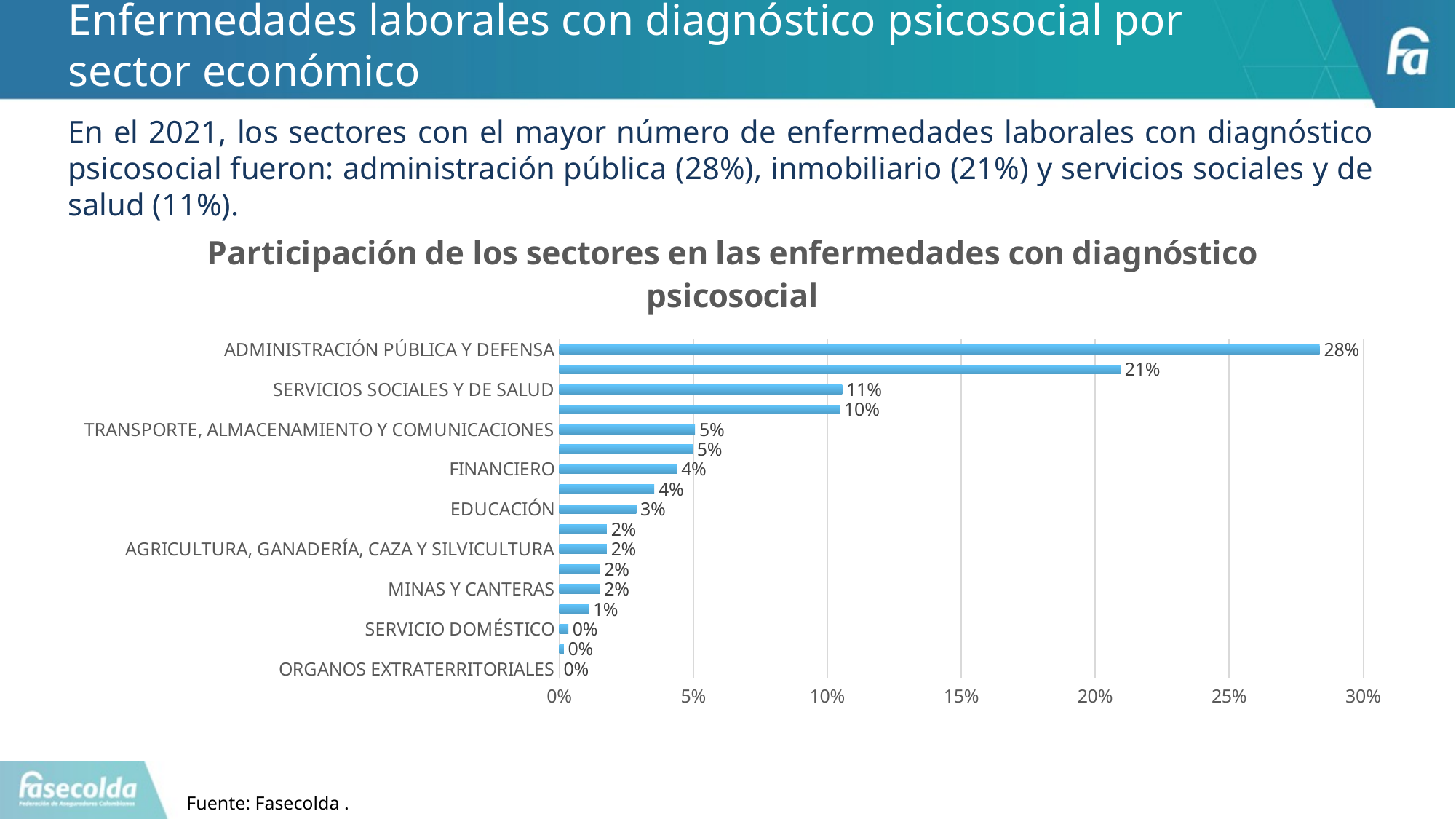
What kind of chart is shown on the slide? bar chart Is the value for ADMINISTRACIÓN PÚBLICA Y DEFENSA greater or less than 25%? greater What is the value for EDUCACIÓN? 3% Which sector has the highest share in the chart? ADMINISTRACIÓN PÚBLICA Y DEFENSA What is the title of the chart? Participación de los sectores en las enfermedades con diagnóstico psicosocial What is the difference between the values for ADMINISTRACIÓN PÚBLICA Y DEFENSA and SERVICIOS SOCIALES Y DE SALUD? 17% What is the value for ADMINISTRACIÓN PÚBLICA Y DEFENSA? 28% What is the value for TRANSPORTE, ALMACENAMIENTO Y COMUNICACIONES? 5% What is the value for MINAS Y CANTERAS? 2% Which is larger, the value for FINANCIERO or the value for EDUCACIÓN? FINANCIERO What is the value for FINANCIERO? 4% What is the value for SERVICIOS SOCIALES Y DE SALUD? 11%